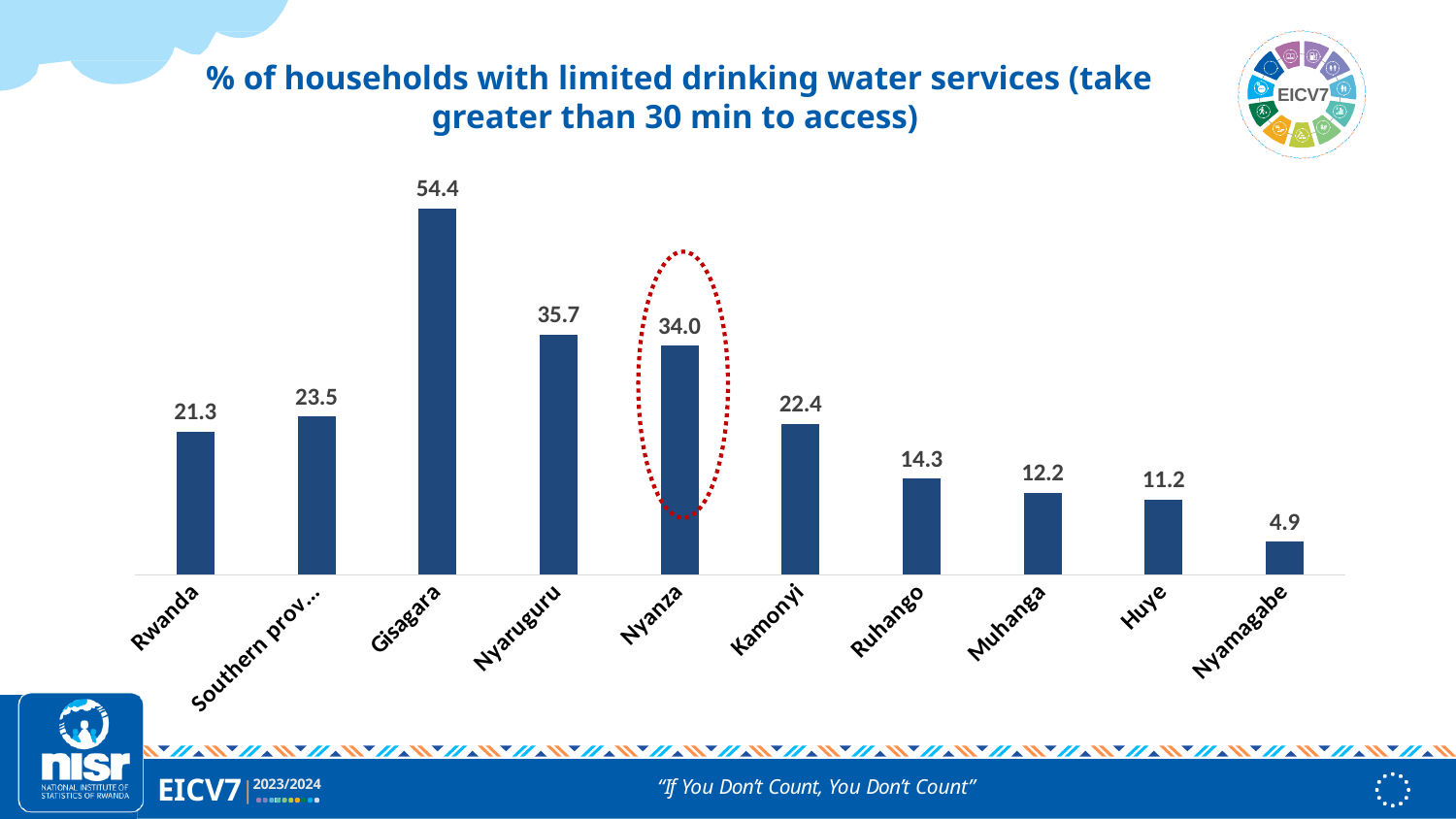
Which category has the lowest value? Nyamagabe How many categories are shown on the x axis? 10 Which category has the highest value? Gisagara What kind of chart is this? Bar chart What is the value for Nyamagabe? 4.9 What is the difference between the values for Gisagara and Nyaruguru? 18.7 What is the difference between the values for Nyanza and Rwanda? 12.7 What is the value for Nyanza? 34.0 Which is larger, the value for Kamonyi or the value for Ruhango? Kamonyi What is the value for Gisagara? 54.4 What is the value for Rwanda? 21.3 Which category is highlighted with a red dotted ellipse? Nyanza